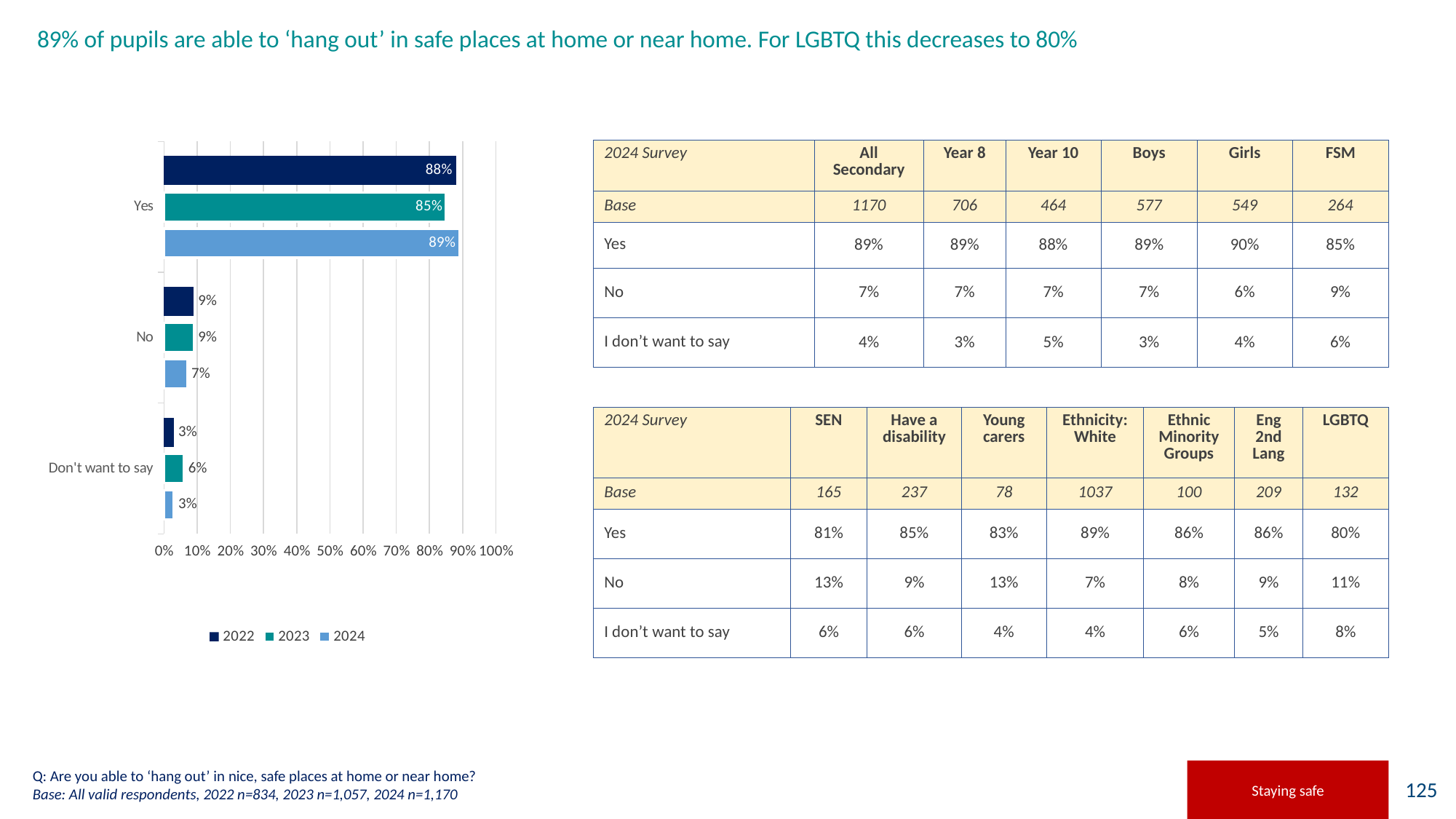
Which is larger, the 'Don't want to say' value for 2023 or for 2024? 2023 What percentage of pupils answered 'Yes' in 2024? 89% What percentage of pupils answered 'No' in 2022? 9% Which years are listed in the chart legend? 2022, 2023, 2024 How many series does the chart legend list? 3 What kind of chart is shown on the slide? Bar chart What percentage of pupils answered 'Don't want to say' in 2023? 6% Which year had the lowest share of pupils answering 'Yes'? 2023 How many response categories are shown on the chart? 3 What is the difference between the 'Yes' values for 2024 and 2023? 4% Is the 'Yes' value for 2022 greater or less than 80%? greater Which year had the highest share of pupils answering 'Yes'? 2024